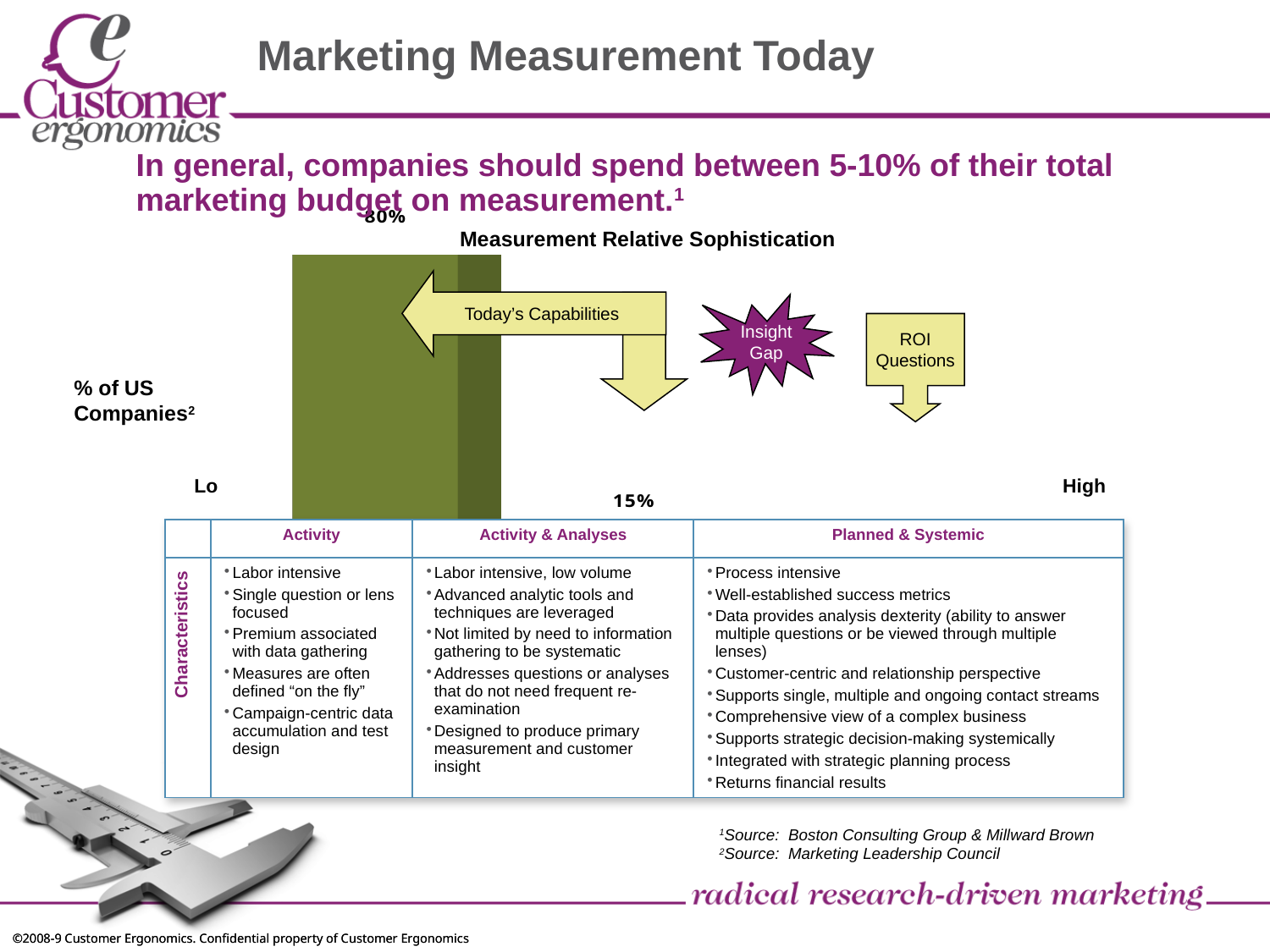
What is the difference between the 80% value and the 15% value shown in the chart? 65% What kind of chart is shown on the slide? bar chart Is the value for the tall green bar in the chart greater or less than 50%? greater Which level has the larger share of US companies in the chart, Activity or Activity & Analyses? Activity What percentage is printed for the Activity & Analyses level in the chart? 15% What percentage is printed above the tall green bar in the chart? 80% How many sophistication levels are listed along the bottom of the chart (Activity, Activity & Analyses, Planned & Systemic)? 3 What is the title of the chart on the slide? Measurement Relative Sophistication What is the label on the vertical axis of the chart? % of US Companies